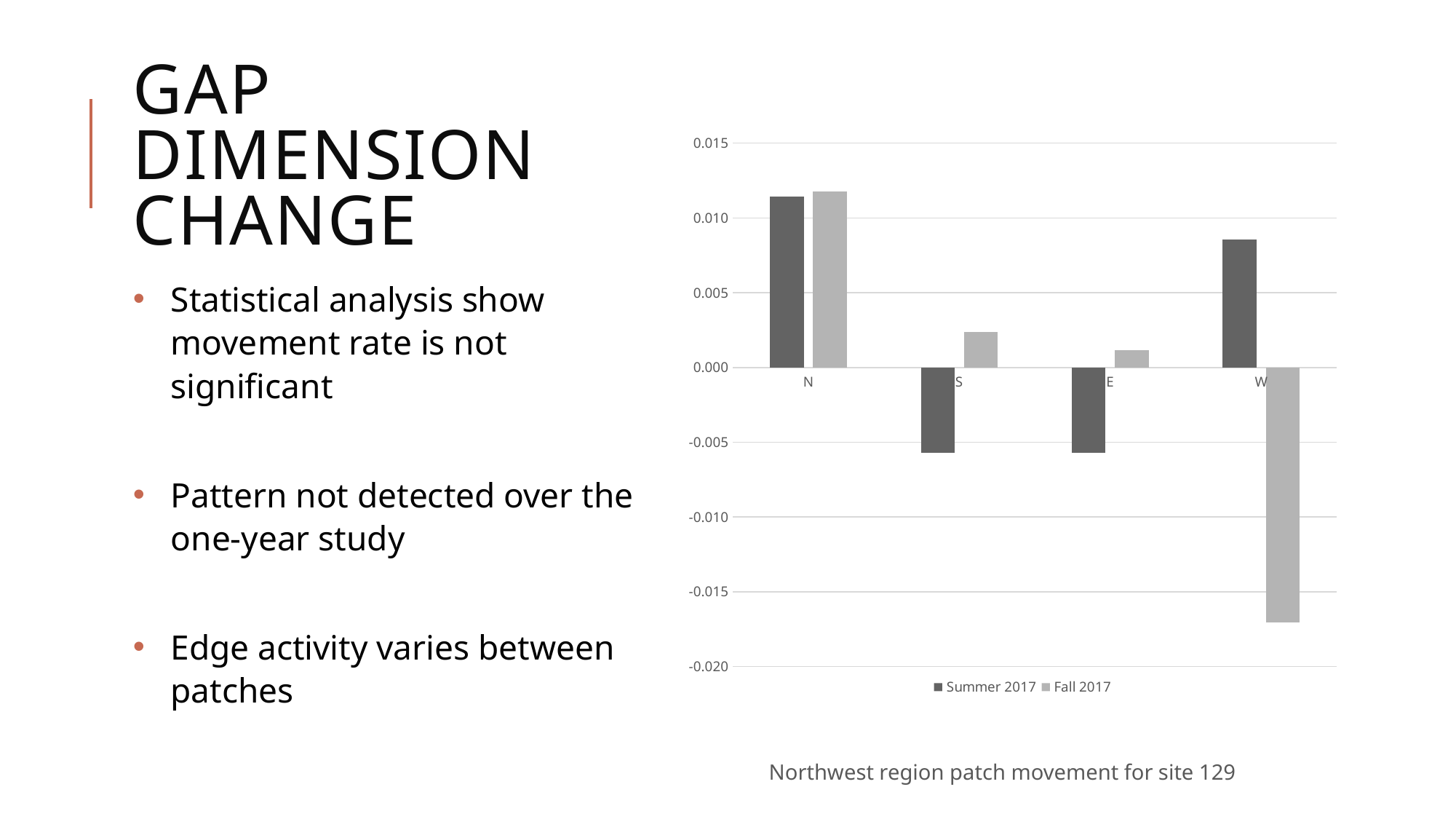
What caption appears below the chart? Northwest region patch movement for site 129 How many series does the chart's legend list? 2 How many categories are shown on the x axis of the chart? 4 What kind of chart is shown on the slide? Bar chart Is the Summer 2017 value for W greater or less than 0.010? less Which category has the highest Fall 2017 value? N Is the Summer 2017 value for N greater or less than 0.010? greater Which category has the highest Summer 2017 value? N For category W, which series has the larger value, Summer 2017 or Fall 2017? Summer 2017 Which category has the lowest Fall 2017 value? W Is the Fall 2017 value for W greater or less than -0.015? less What are the two series named in the chart's legend? Summer 2017 and Fall 2017